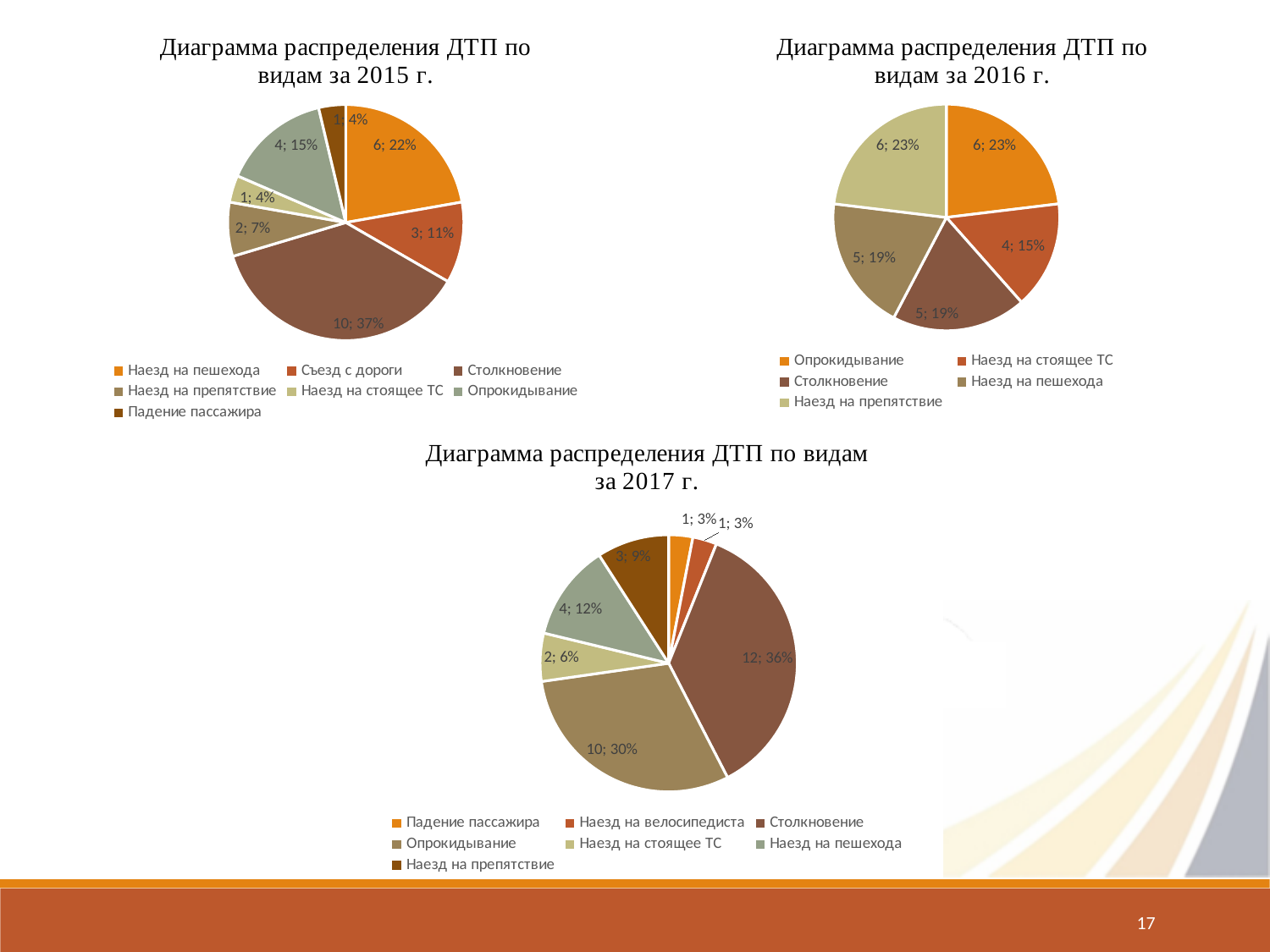
In the 2017 chart, what share of the pie does Наезд на пешехода take? 12% In the 2017 chart, which is larger, Столкновение or Опрокидывание? Столкновение In the 2016 chart, which category has the smallest slice? Наезд на стоящее ТС In the 2016 chart (Диаграмма распределения ДТП по видам за 2016 г.), what is the data label for Наезд на стоящее ТС? 4; 15% In the 2015 chart, what share of the pie does Наезд на пешехода take? 22% What type of chart is used for the 2017 data? Pie chart In the 2015 chart, what is the difference in count between Столкновение and Опрокидывание? 6 In the 2016 chart, how many categories are shown? 5 In the 2015 chart (Диаграмма распределения ДТП по видам за 2015 г.), what is the data label for Столкновение? 10; 37% In the 2017 chart (Диаграмма распределения ДТП по видам за 2017 г.), what is the data label for Опрокидывание? 10; 30% In the 2015 chart, how many categories does the legend list? 7 In the 2015 chart, which category has the largest slice? Столкновение